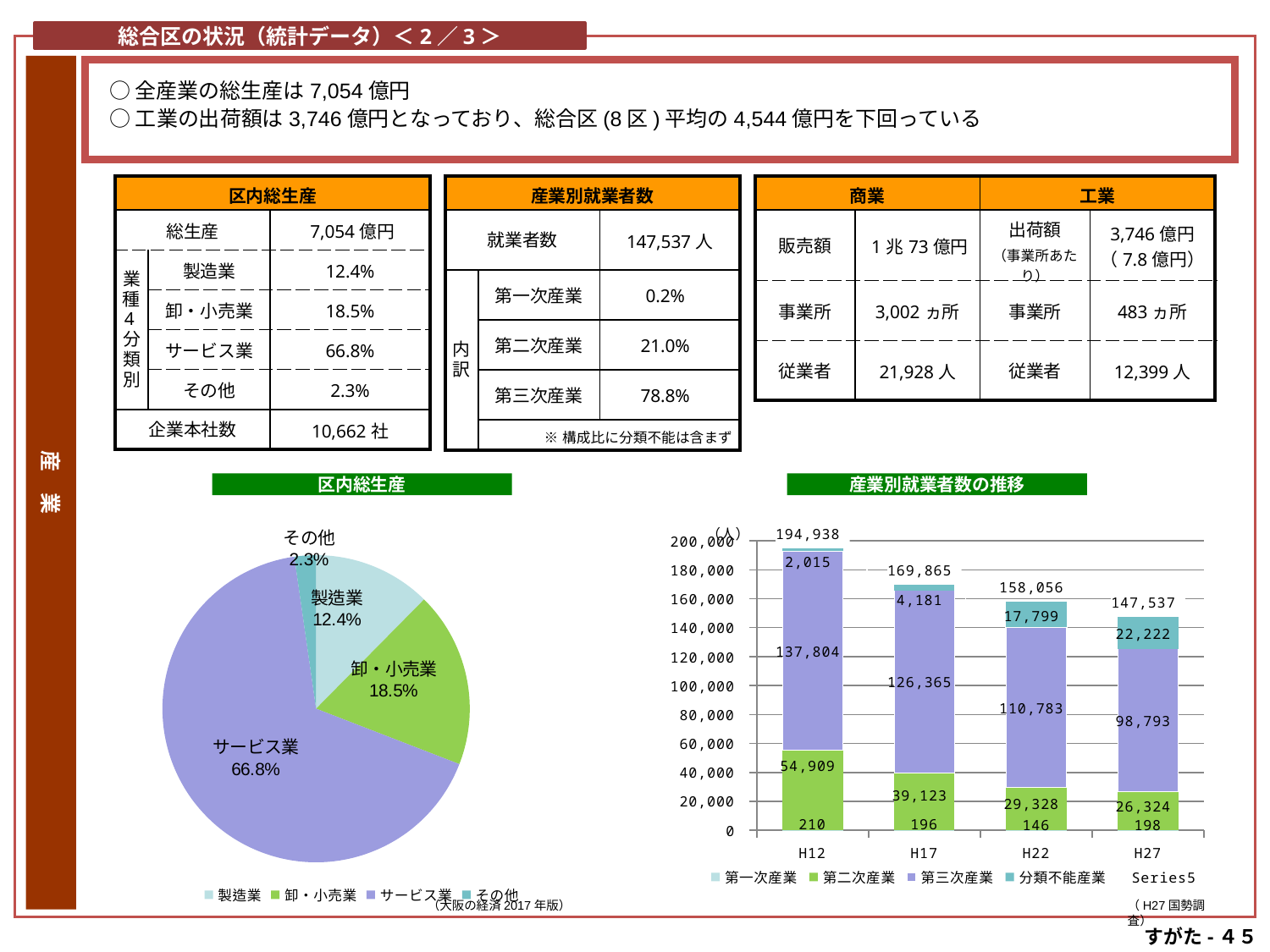
How many slices does the 区内総生産 pie chart have? 4 In the 産業別就業者数の推移 chart, how do the total values change from H12 to H27? They fall In the 産業別就業者数の推移 chart, is the 分類不能産業 value larger in H22 or H27? H27 In the 区内総生産 pie chart, what share does サービス業 have? 66.8% How many entries does the legend of the 産業別就業者数の推移 chart list? 5 In the 区内総生産 pie chart, what is the difference in percentage points between 卸・小売業 and 製造業? 6.1 In the 区内総生産 pie chart, which category has the smallest slice? その他 In the 産業別就業者数の推移 chart, what is the total of the stacked bar for H17? 169,865 In the 産業別就業者数の推移 chart, what is the difference between the 第二次産業 values for H12 and H27? 28,585 In the 産業別就業者数の推移 chart, which year has the highest total? H12 What type of chart is the 区内総生産 chart? Pie chart In the 産業別就業者数の推移 chart, what is the value for 第三次産業 in H22? 110,783